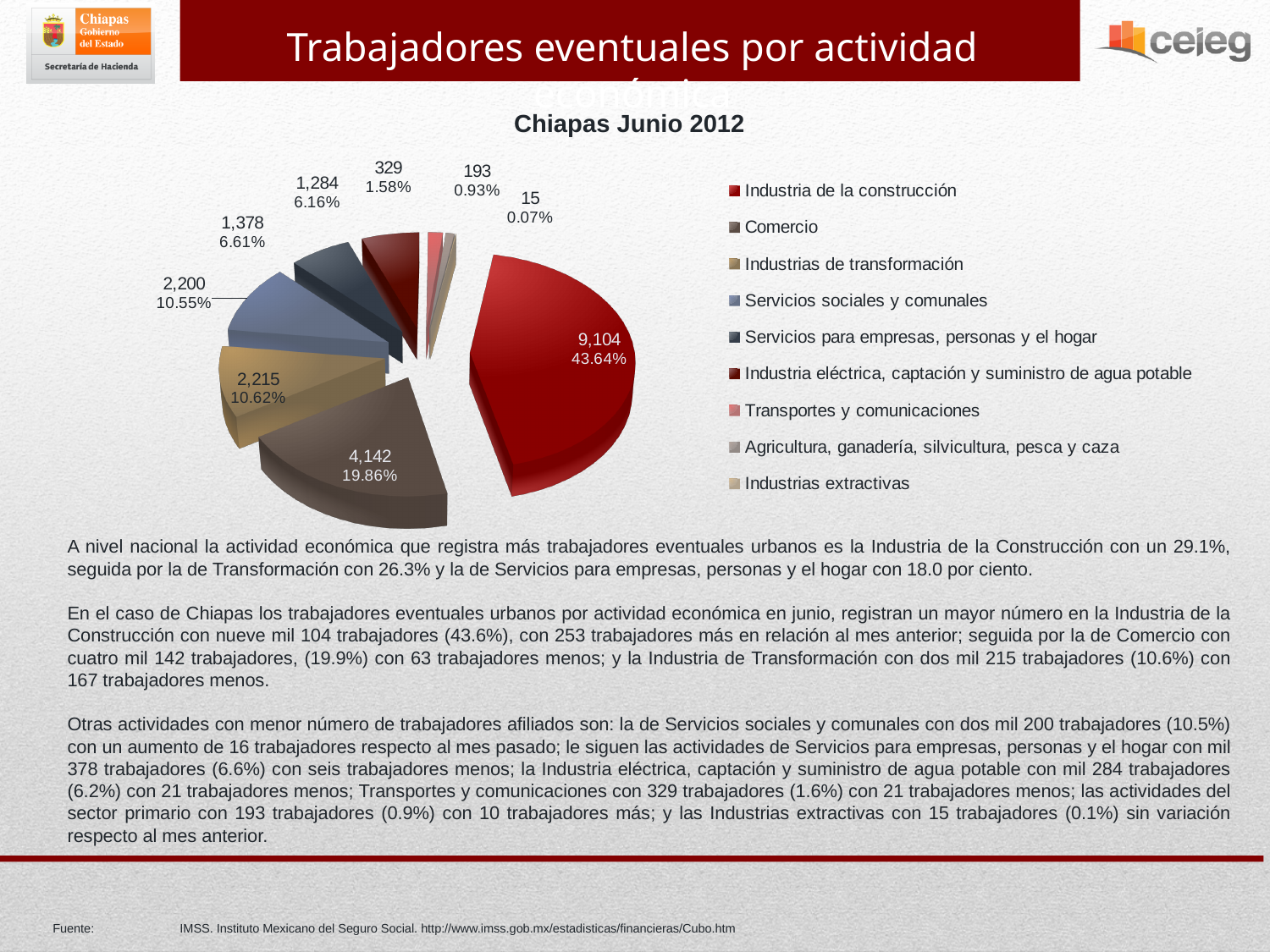
What is the title shown directly above the pie chart? Chiapas Junio 2012 Which category has the largest slice of the pie? Industria de la construcción How many categories does the legend of the pie chart list? 9 What share of the pie does Comercio represent? 19.86% Which is larger, the value for Transportes y comunicaciones or the value for Agricultura, ganadería, silvicultura, pesca y caza? Transportes y comunicaciones What is the value shown for Industria eléctrica, captación y suministro de agua potable? 1,284 What is the difference between the values for Industria de la construcción and Comercio? 4,962 What is the value shown for Industria de la construcción? 9,104 What kind of chart is shown on the slide? Pie chart What percentage is shown for Servicios sociales y comunales? 10.55% What is the value shown for Industrias de transformación? 2,215 Which category has the smallest slice of the pie? Industrias extractivas